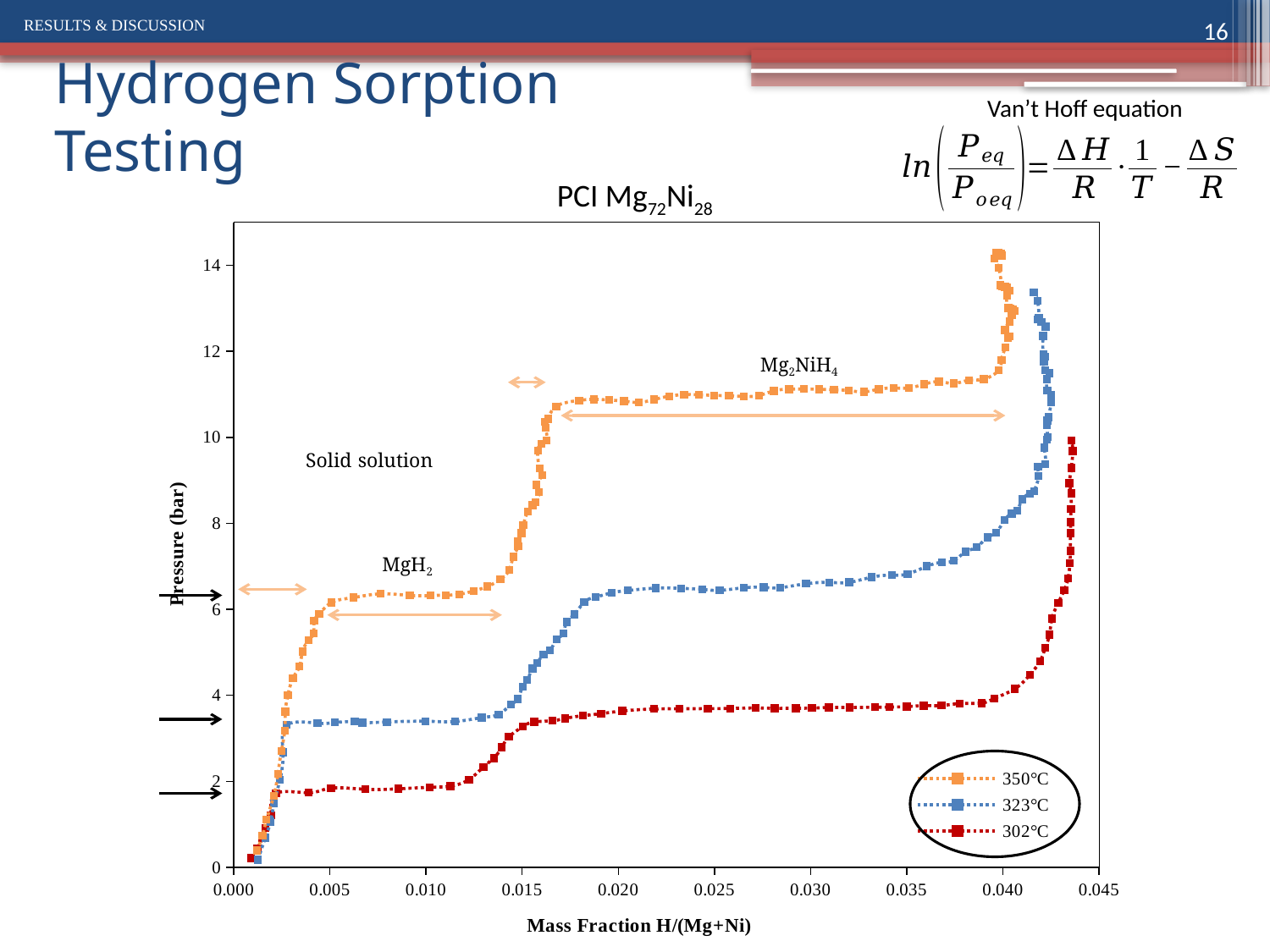
Is the upper plateau pressure of the 302°C series greater or less than 4 bar? less Is the lower plateau pressure of the 302°C series greater or less than 2 bar? less How many series does the chart legend list? 3 What is the title of the chart's x axis? Mass Fraction H/(Mg+Ni) At a mass fraction of 0.030, which series shows the higher pressure, 350°C or 302°C? 350°C Is the upper plateau pressure of the 350°C series (labelled Mg2NiH4) greater or less than 10 bar? greater Which series has the lowest plateau pressures on the chart? 302°C What kind of chart is shown on the slide? Scatter (line) chart Does the pressure for each series generally rise or fall as the mass fraction increases along the x axis? rise Which temperatures are listed in the chart legend? 350°C, 323°C, 302°C Which series reaches the highest pressure on the chart? 350°C